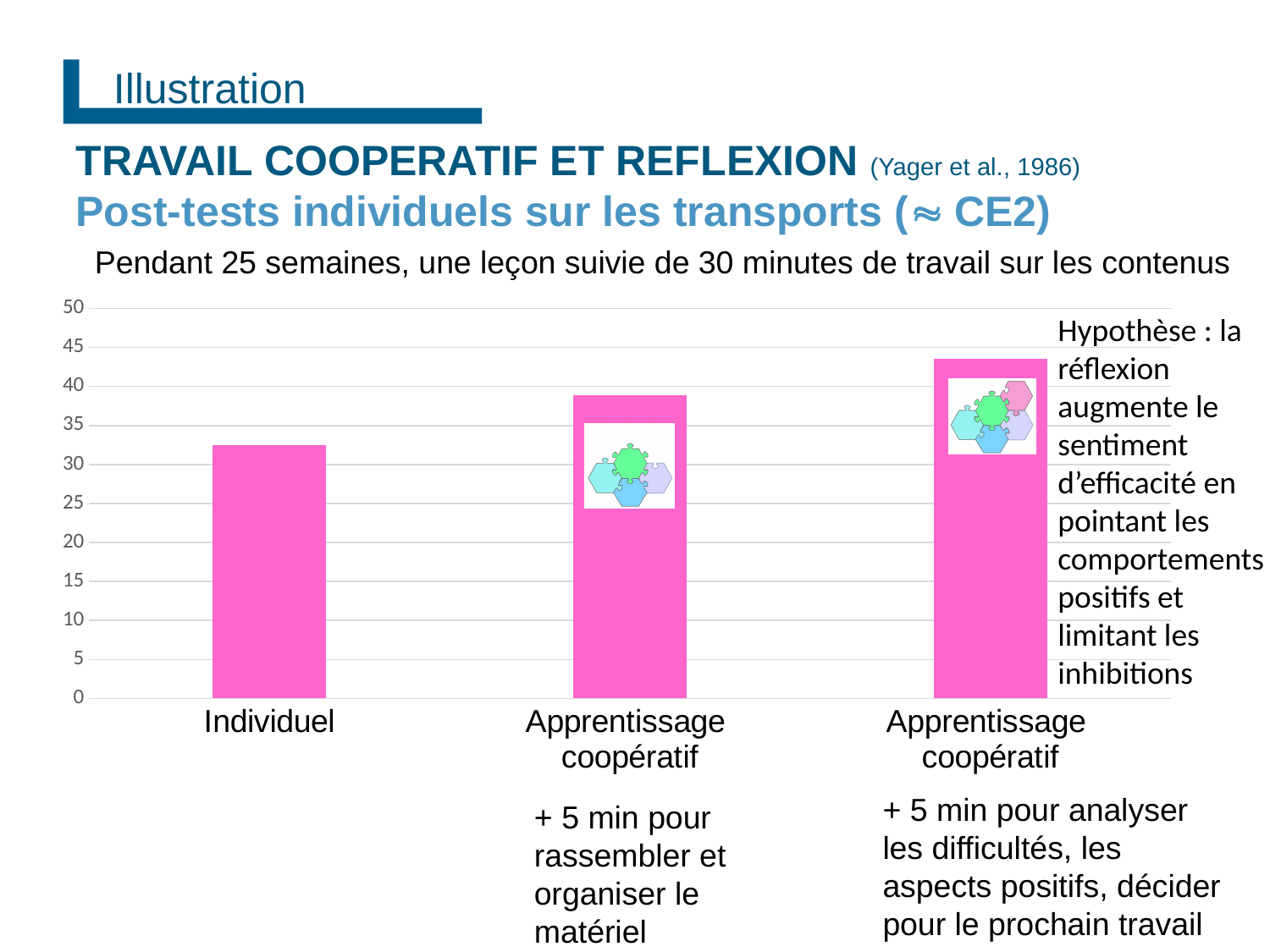
What colour are the bars in the chart? pink Which is larger: the value for Individuel or the value for the middle Apprentissage coopératif bar? the middle Apprentissage coopératif bar Is the value for Individuel greater or less than 30? greater Which bar is the tallest in the chart? the rightmost Apprentissage coopératif bar What is the highest value shown on the vertical axis of the chart? 50 How many bars does the chart show? 3 What kind of chart is shown on the slide? bar chart Do the bar values rise or fall from left to right across the chart? rise Is the value for the rightmost Apprentissage coopératif bar greater or less than 40? greater Which category has the lowest value in the chart? Individuel Is the value for Individuel greater or less than 35? less